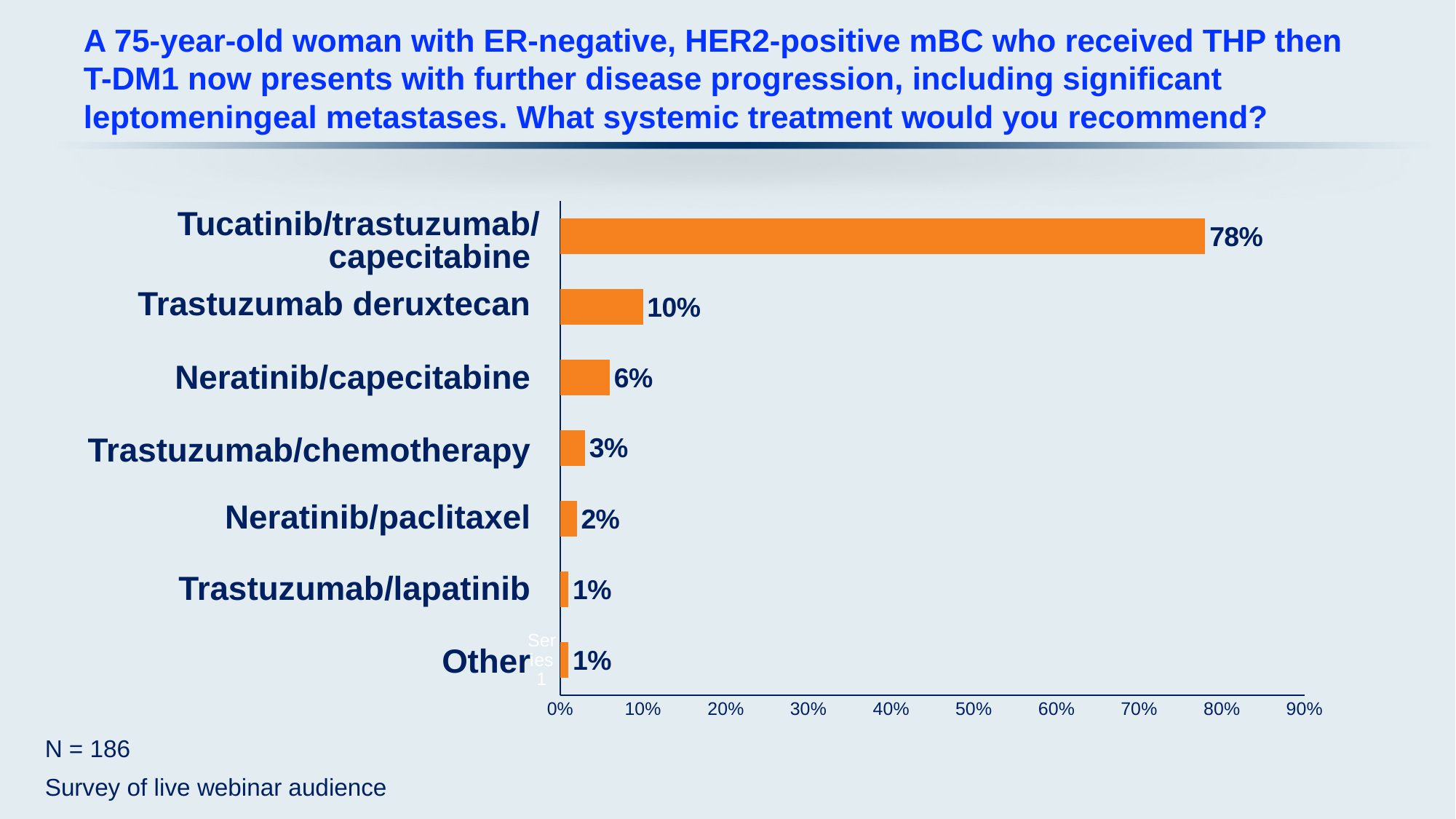
What percentage of respondents recommended Trastuzumab deruxtecan? 10% What percentage of respondents recommended Tucatinib/trastuzumab/capecitabine? 78% Which treatment option received the highest share of responses? Tucatinib/trastuzumab/capecitabine Which has a larger value, Neratinib/capecitabine or Neratinib/paclitaxel? Neratinib/capecitabine Is the value for Tucatinib/trastuzumab/capecitabine greater or less than 70%? greater What is the value shown for Neratinib/capecitabine? 6% What kind of chart is shown on the slide? Bar chart What is the difference in percentage points between Tucatinib/trastuzumab/capecitabine and Trastuzumab deruxtecan? 68% What is the difference between the values for Trastuzumab/chemotherapy and Neratinib/paclitaxel? 1% How many treatment options are listed on the chart? 7 What is the value shown for Trastuzumab/chemotherapy? 3% What is the sample size (N) stated on the slide? N = 186